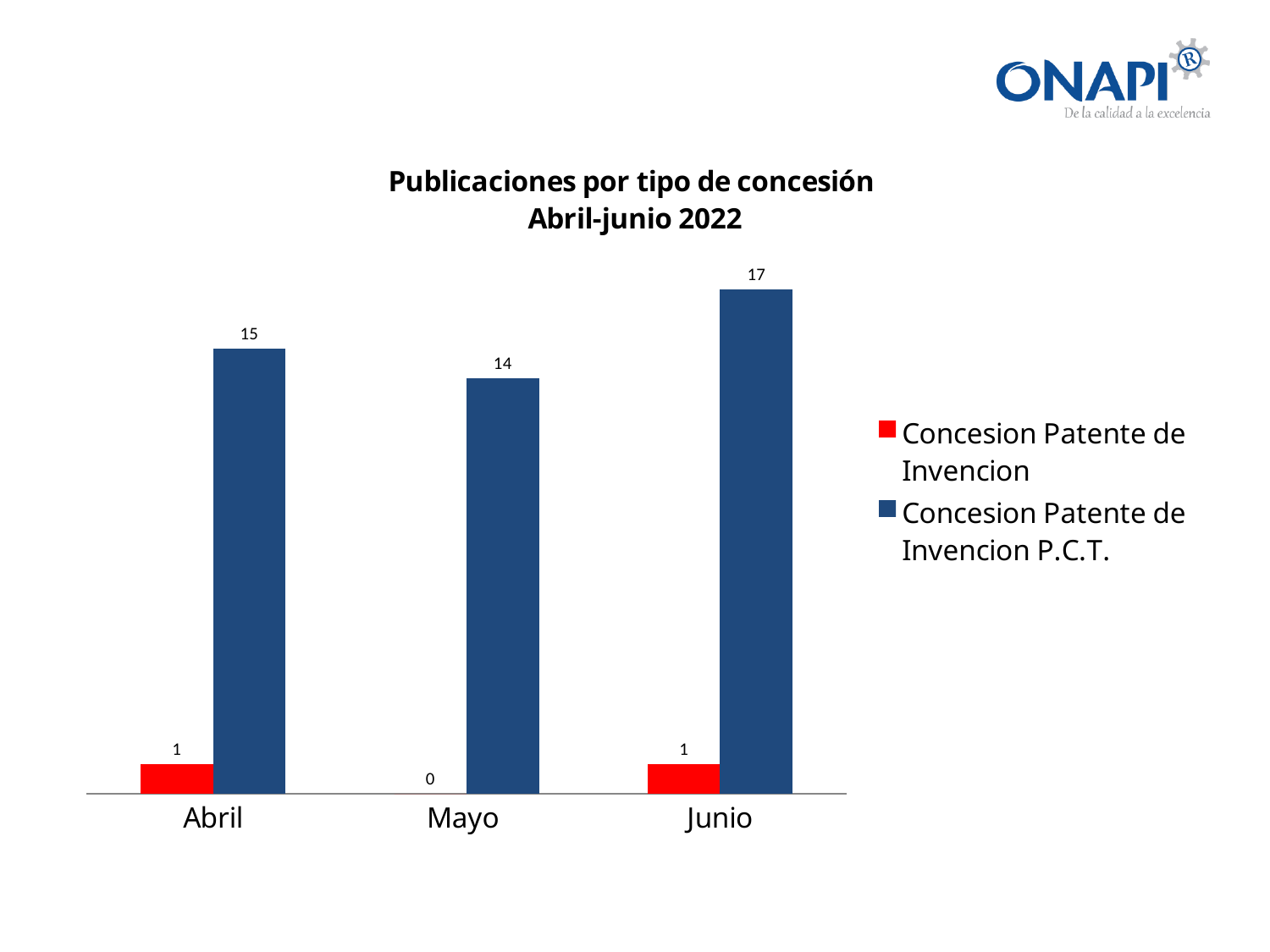
Which month has the lowest value for Concesion Patente de Invencion P.C.T.? Mayo How many months are shown on the x axis? 3 How many series does the legend list? 2 Which month has the highest value for Concesion Patente de Invencion P.C.T.? Junio What is the value for Concesion Patente de Invencion in Mayo? 0 What is the title of the chart? Publicaciones por tipo de concesión Abril-junio 2022 What kind of chart is shown on the slide? Bar chart What is the difference between the Concesion Patente de Invencion P.C.T. values for Junio and Abril? 2 What is the value for Concesion Patente de Invencion in Junio? 1 What is the value for Concesion Patente de Invencion P.C.T. in Abril? 15 Which is larger: Concesion Patente de Invencion P.C.T. in Abril or in Mayo? Abril What is the value for Concesion Patente de Invencion P.C.T. in Mayo? 14